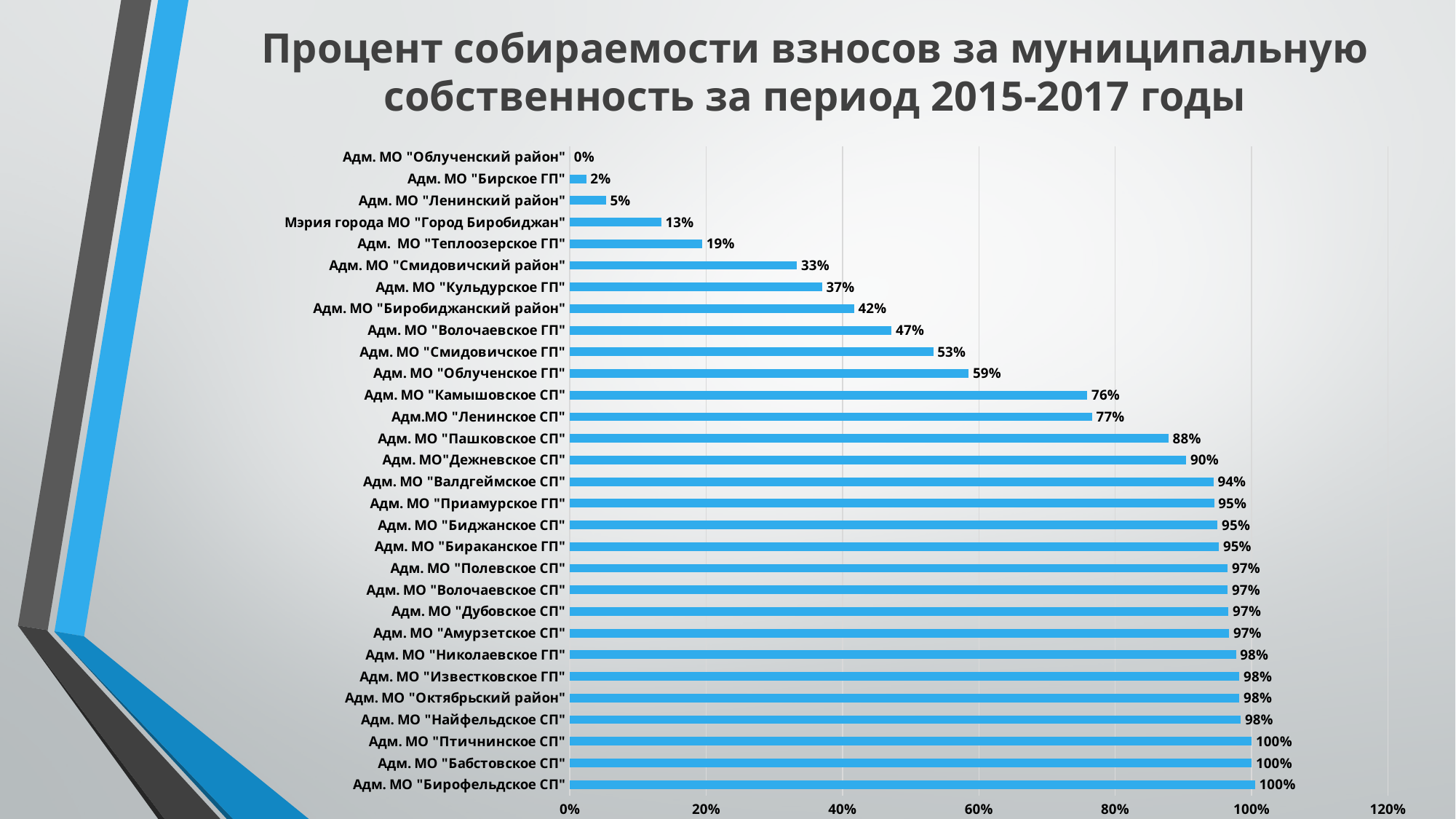
How many categories are shown in the chart? 30 What is the value for Адм. МО "Смидовичский район"? 33% Is the value for Адм. МО "Смидовичское ГП" greater or less than 40%? greater Which is larger, the value for Адм. МО "Теплоозерское ГП" or Адм. МО "Биробиджанский район"? Адм. МО "Биробиджанский район" What kind of chart is shown on the slide? bar chart What is the value for Адм. МО "Камышовское СП"? 76% What is the value for Адм. МО "Пашковское СП"? 88% What is the value for Мэрия города МО "Город Биробиджан"? 13% What is the difference between the values for Адм. МО "Облученское ГП" and Адм. МО "Волочаевское ГП"? 12% What is the title of the chart? Процент собираемости взносов за муниципальную собственность за период 2015-2017 годы Which category has the lowest value? Адм. МО "Облученский район" What is the difference between the values for Адм. МО "Дежневское СП" and Адм. МО "Кульдурское ГП"? 53%